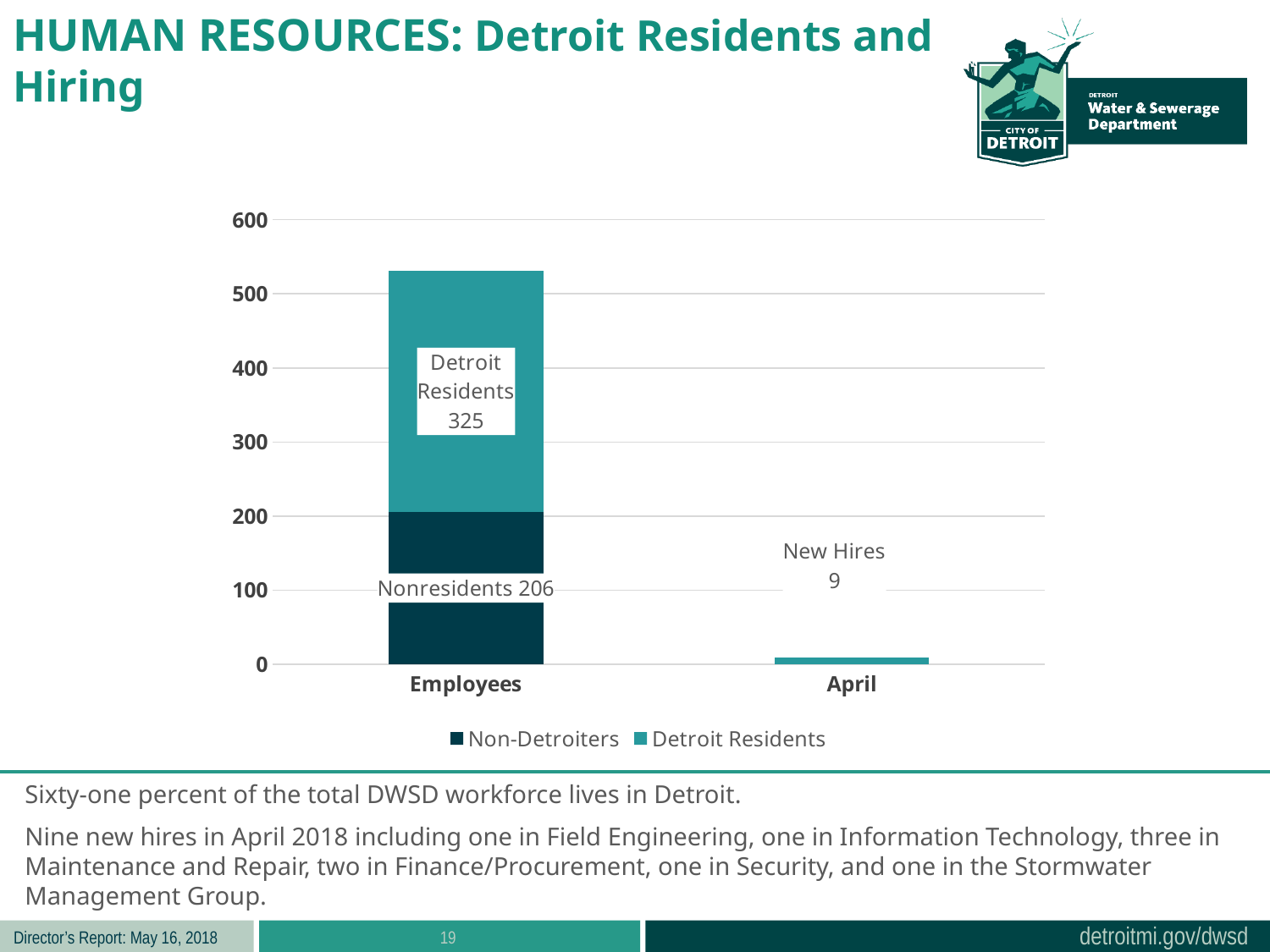
How many New Hires are shown for April? 9 What is the difference between Detroit Residents (325) and Nonresidents (206) in the Employees bar? 119 Which category has the taller bar, Employees or April? Employees How many series does the legend list? 2 In the Employees bar, which is larger: Detroit Residents or Nonresidents? Detroit Residents What kind of chart is shown on the slide? Stacked bar chart Is the total height of the Employees bar greater or less than 500? greater What is the value for Detroit Residents in the Employees bar? 325 What is the total of the stacked Employees bar? 531 What is the value for Nonresidents in the Employees bar? 206 What are the two entries in the chart legend? Non-Detroiters and Detroit Residents How many categories are shown on the x axis? 2